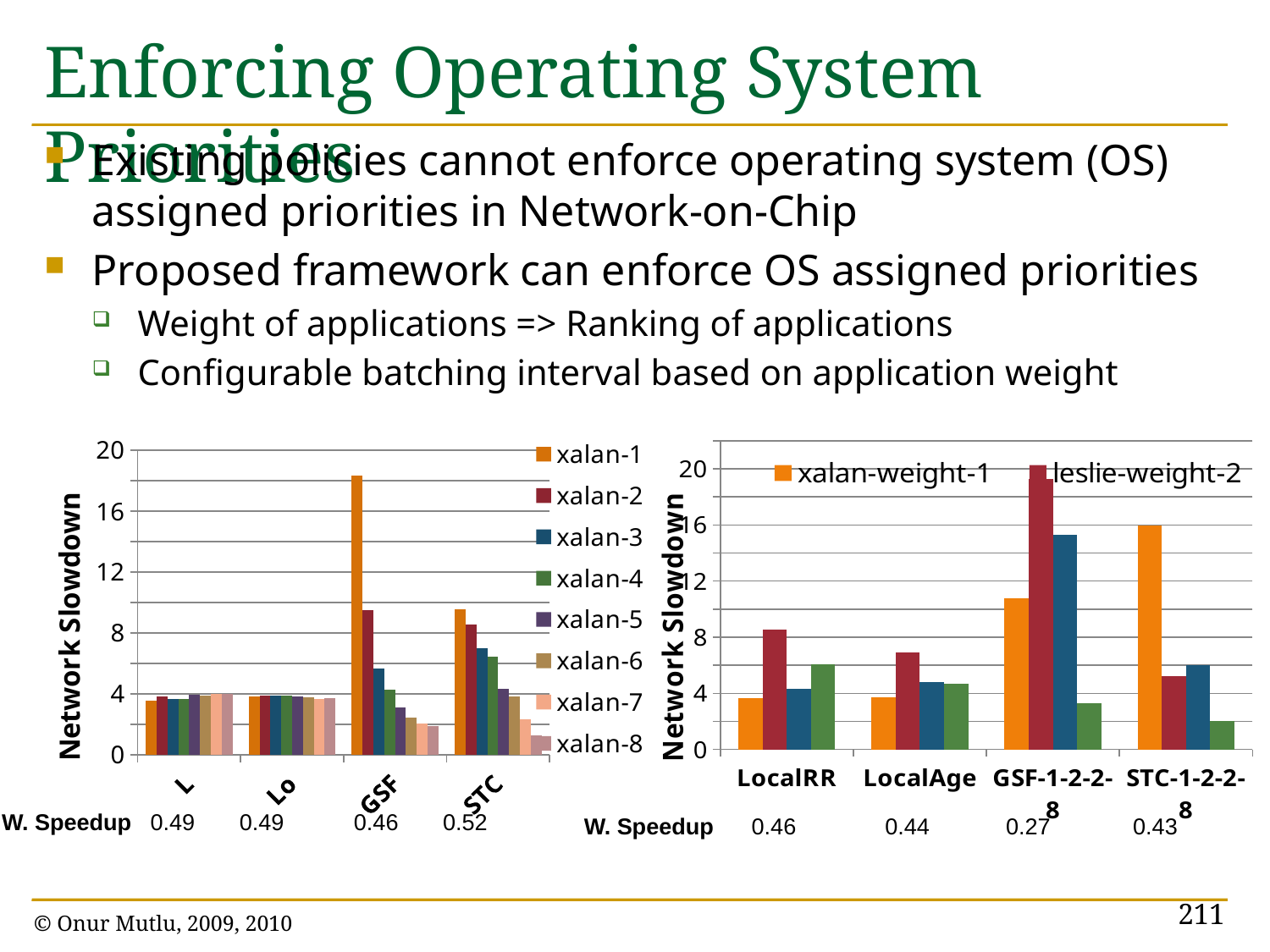
In the right chart, is the leslie-weight-2 value for GSF-1-2-2-8 greater or less than 16? greater In the right chart, which category has the highest xalan-weight-1 bar? STC-1-2-2-8 In the right chart, is the xalan-weight-1 value for LocalRR greater or less than 4? less In the right chart, is the xalan-weight-1 value for GSF-1-2-2-8 greater or less than 8? greater What kind of chart is the left chart on the slide? bar chart How many series does the legend of the left chart list? 8 How many categories are shown on the x axis of the right chart? 4 In the right chart, for LocalRR, which is larger: xalan-weight-1 or leslie-weight-2? leslie-weight-2 In the left chart, which category has the highest xalan-1 bar? GSF What is the y-axis title of the left chart? Network Slowdown